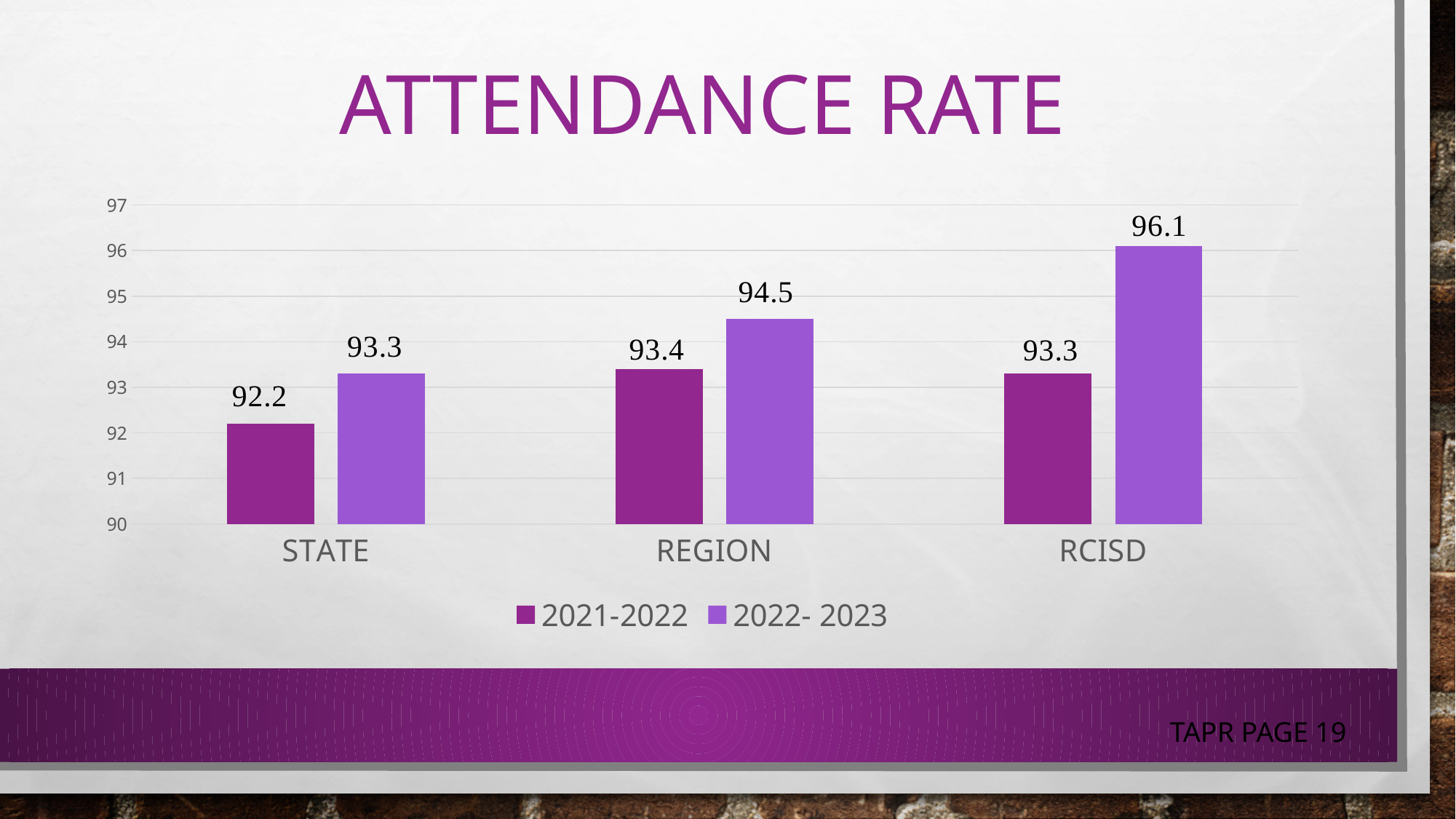
What is the difference between the REGION and STATE attendance rates in 2022- 2023? 1.2 Which category has the lowest attendance rate in 2021-2022? STATE What is the attendance rate for REGION in 2021-2022? 93.4 What is the attendance rate for STATE in 2021-2022? 92.2 What is the title of the chart? ATTENDANCE RATE What is the difference between the RCISD attendance rate in 2022- 2023 and in 2021-2022? 2.8 Which is larger, the REGION attendance rate in 2022- 2023 or the RCISD attendance rate in 2022- 2023? RCISD Which category has the highest attendance rate in 2022- 2023? RCISD What kind of chart is shown on the slide? Bar chart What is the attendance rate for RCISD in 2022- 2023? 96.1 How many series does the legend list? 2 How many categories are shown on the x axis? 3